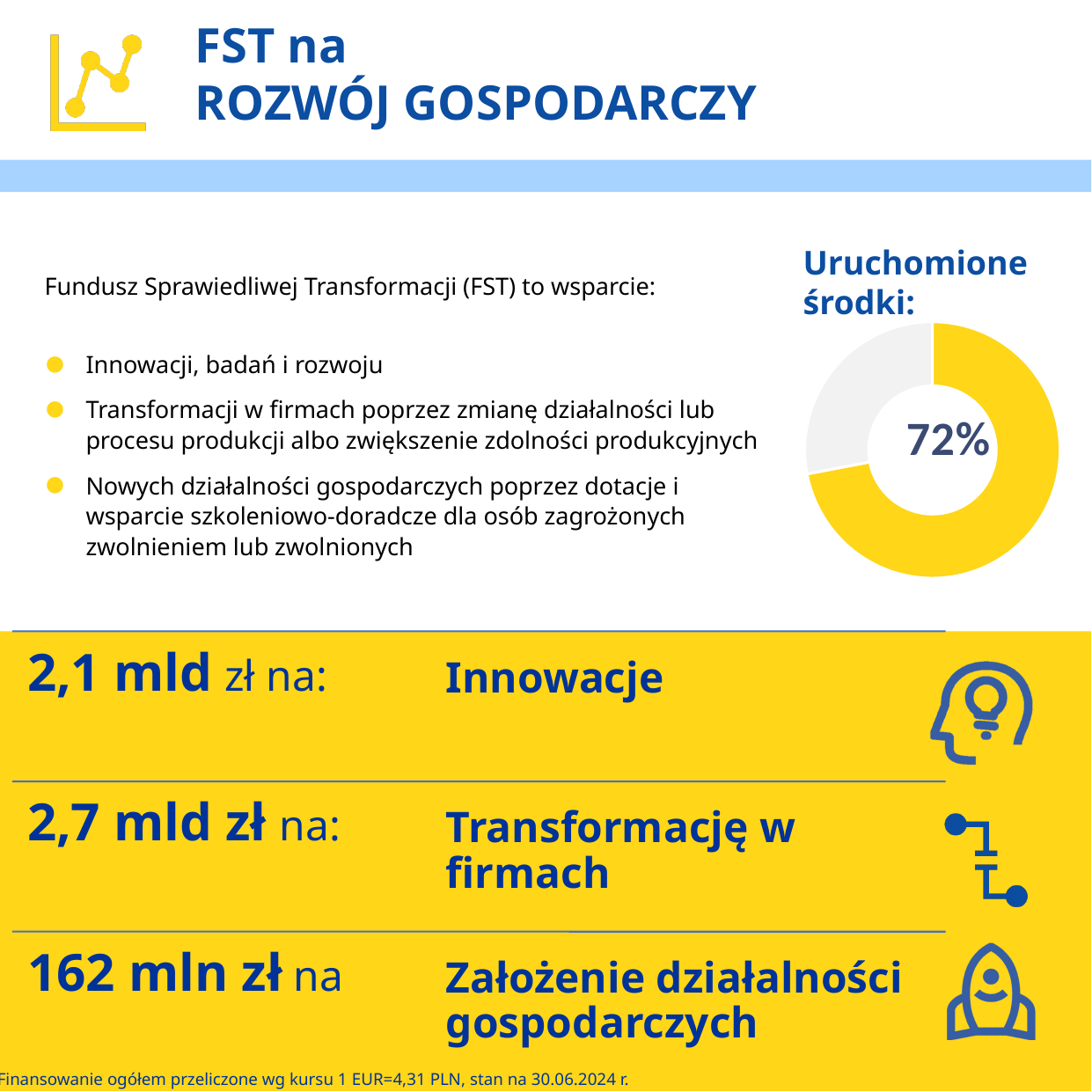
What kind of chart is shown under the heading "Uruchomione środki:"? Doughnut (pie) chart Is the share shown by the yellow segment of the doughnut chart greater or less than 50%? greater What colour is the segment of the doughnut chart that represents the 72% share? Yellow What percentage is printed in the centre of the doughnut chart? 72% How many segments does the doughnut chart have? 2 Which segment of the doughnut chart is larger, the yellow one or the grey one? The yellow one What is the title above the doughnut chart? Uruchomione środki: